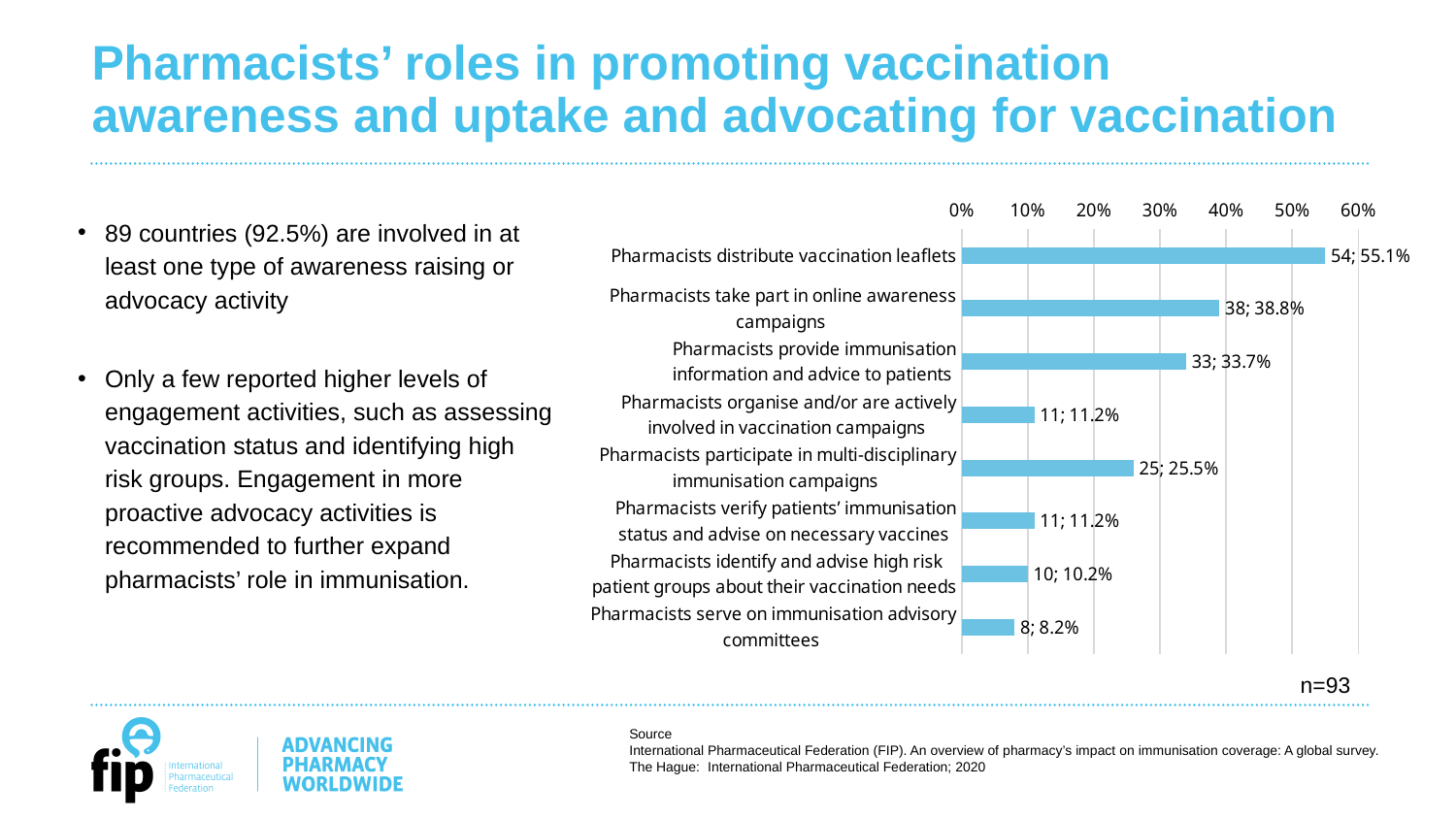
Which is larger: the value for 'Pharmacists participate in multi-disciplinary immunisation campaigns' or for 'Pharmacists provide immunisation information and advice to patients'? Pharmacists provide immunisation information and advice to patients How many categories are shown in the chart? 8 What percentage is shown for 'Pharmacists take part in online awareness campaigns'? 38.8% Is the value for 'Pharmacists organise and/or are actively involved in vaccination campaigns' greater or less than 20%? less What kind of chart is shown on the slide? bar chart What is the sample size noted below the chart? n=93 What is the percentage shown for 'Pharmacists identify and advise high risk patient groups about their vaccination needs'? 10.2% What is the difference in count between 'Pharmacists distribute vaccination leaflets' and 'Pharmacists take part in online awareness campaigns'? 16 Which category has the lowest value in the chart? Pharmacists serve on immunisation advisory committees What is the data label for 'Pharmacists distribute vaccination leaflets'? 54; 55.1% How many countries reported that pharmacists serve on immunisation advisory committees? 8 Which category has the highest value in the chart? Pharmacists distribute vaccination leaflets